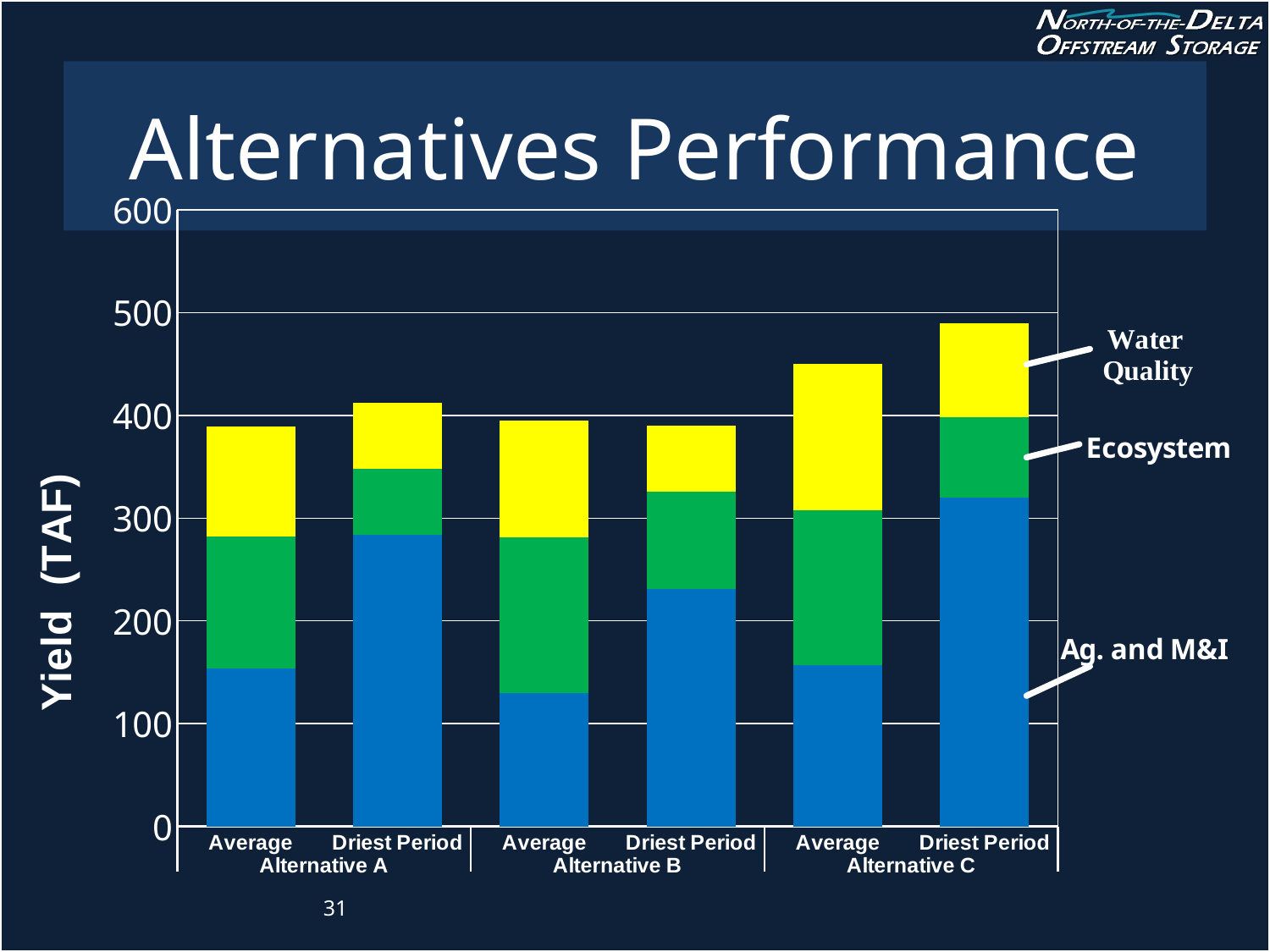
Which bar has the highest total yield? Alternative C Driest Period Is the total yield for Alternative C Average greater or less than 400? greater What kind of chart is shown on the slide? stacked bar chart Is the total yield for Alternative C Driest Period greater or less than 400? greater Which has the larger Ag. and M&I value, Alternative A Driest Period or Alternative A Average? Alternative A Driest Period Which has the larger total yield, Alternative C Driest Period or Alternative A Average? Alternative C Driest Period What is the title of the chart? Alternatives Performance What is the label on the y axis of the chart? Yield (TAF) How many bars are plotted in the chart? 6 Is the Ag. and M&I value for Alternative C Driest Period greater or less than 300? greater How many series does the chart's legend list? 3